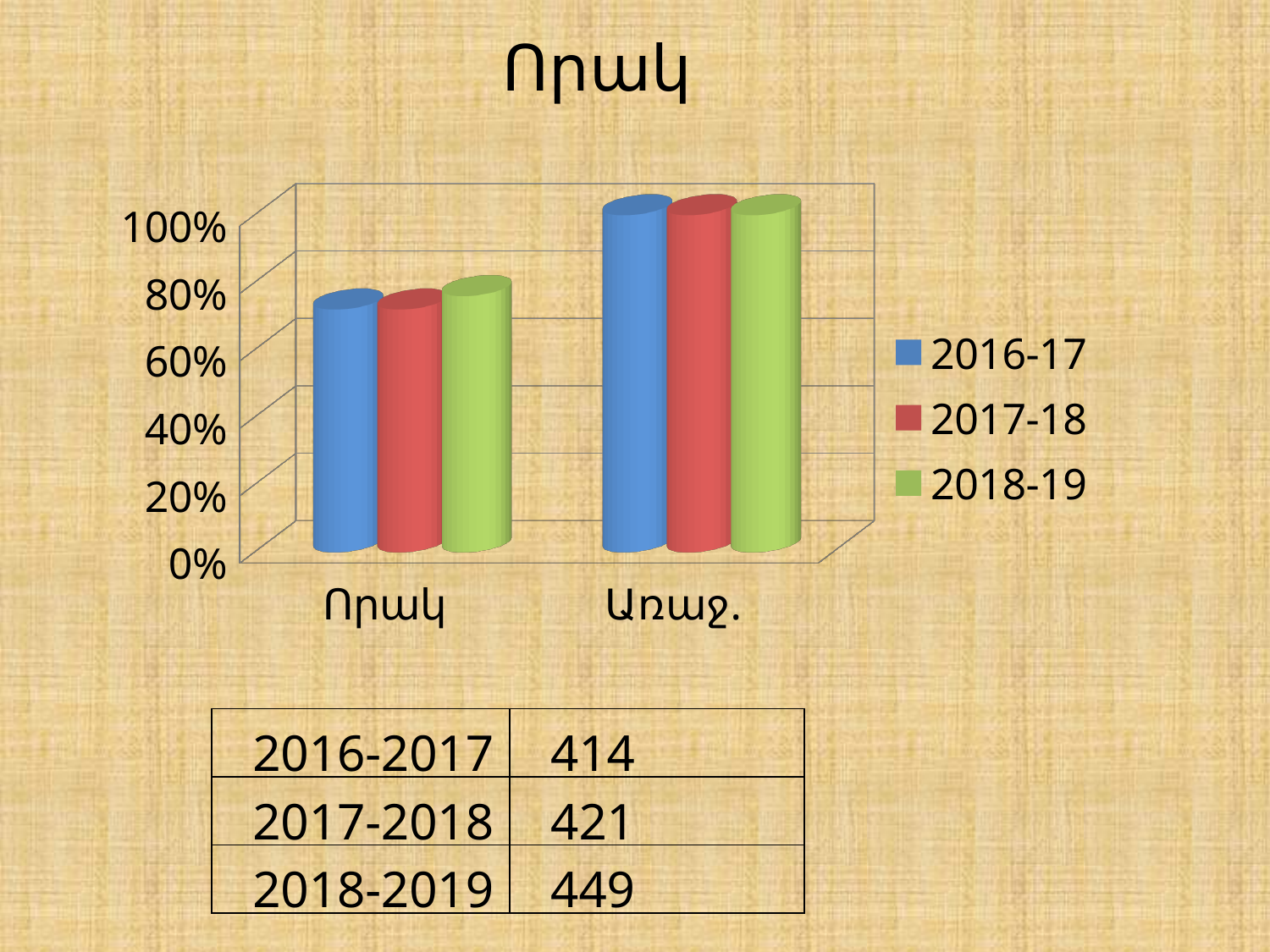
Is the value for 2016-17 in the Որակ category greater or less than 80%? less How many series does the chart legend list? 3 Is the value for 2018-19 in the Առաջ. category greater or less than 80%? greater What kind of chart is shown on the slide? bar chart For the 2016-17 series, which category has the larger value, Որակ or Առաջ.? Առաջ. Is the value for 2016-17 in the Որակ category greater or less than 60%? greater Which category has the highest values across all series in the chart? Առաջ. How many categories are shown on the x axis of the chart? 2 Which series is shown in red in the chart? 2017-18 For the 2018-19 series, which category has the lower value? Որակ What is the title of the chart? Որակ